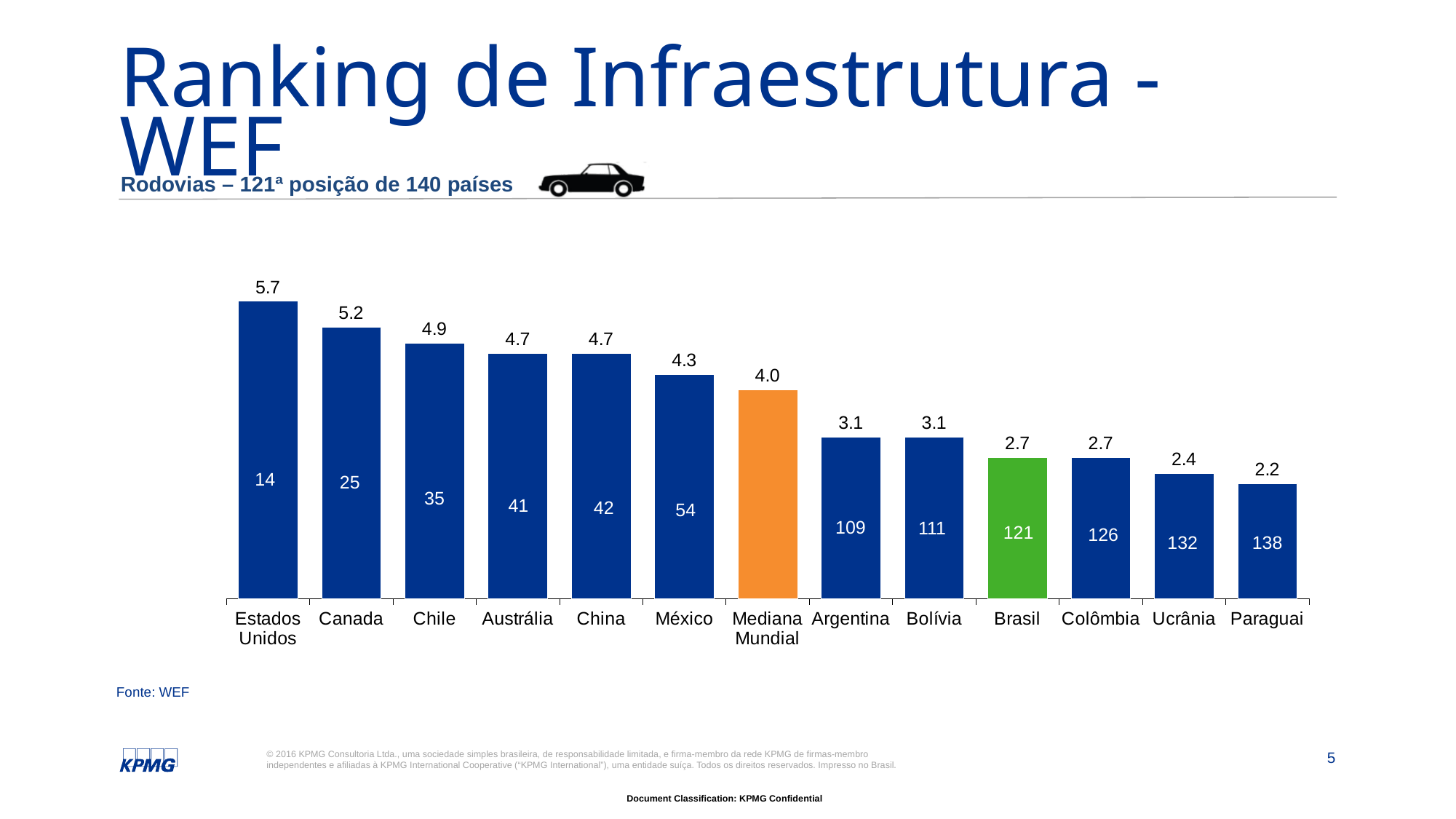
Which has a higher score, Canada or Chile? Canada Which bar in the chart is coloured green? Brasil How many bars are shown in the chart? 13 What score is shown above the bar for Brasil? 2.7 What score is shown for Mediana Mundial? 4.0 What is the difference between the scores of Estados Unidos and Brasil? 3.0 What ranking position is printed inside the bar for México? 54 Do the scores rise or fall from left to right across the chart? Fall Which country has the lowest score in the chart? Paraguai What type of chart is shown on the slide? Bar chart Which country has the highest score in the chart? Estados Unidos What ranking position is printed inside the bar for Brasil? 121